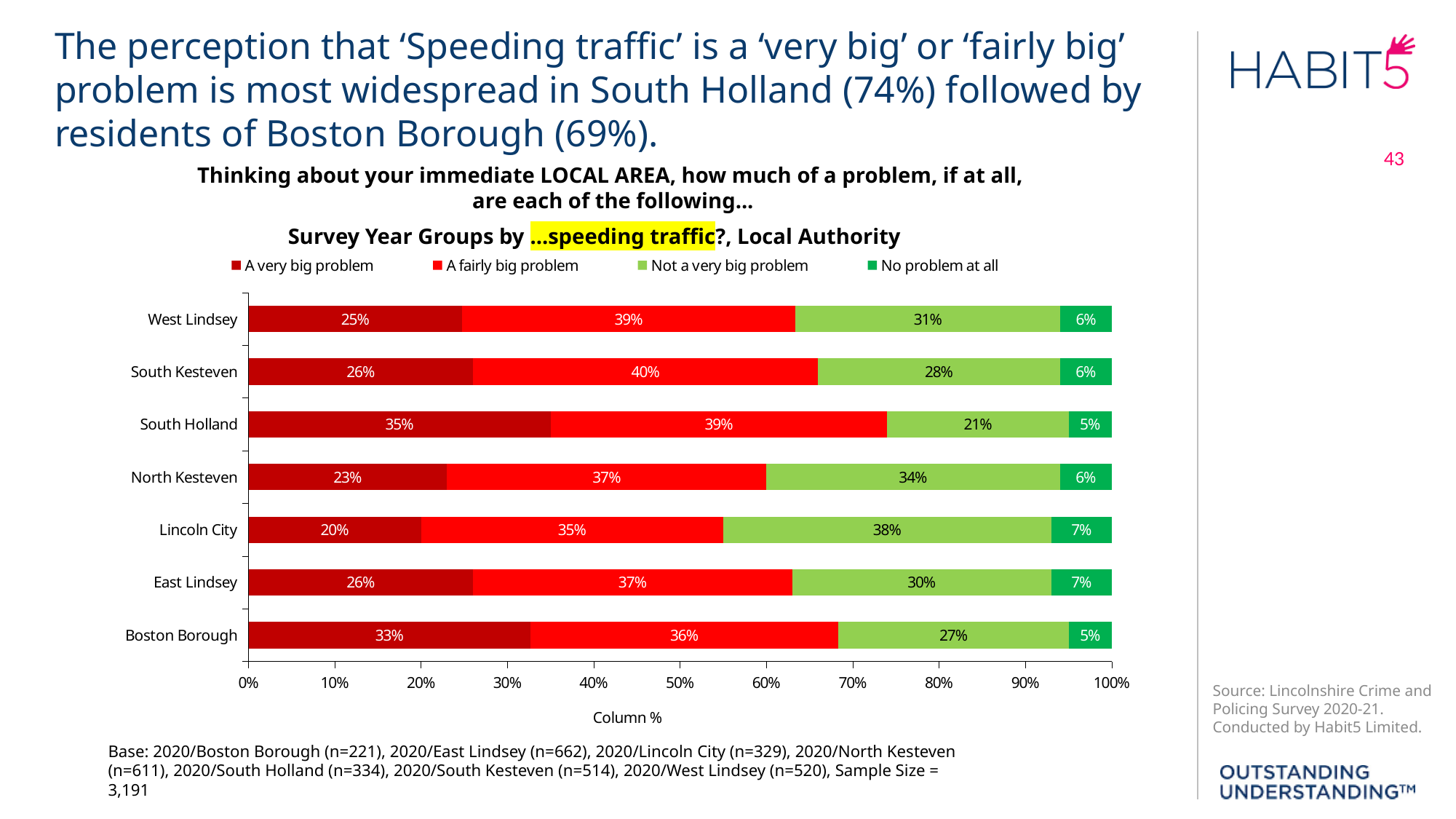
What is the difference between the 'A fairly big problem' values for South Kesteven and Lincoln City? 5 percentage points What percentage of Lincoln City respondents said speeding traffic is 'Not a very big problem'? 38% How many series does the legend list? 4 How many local authorities are shown on the chart? 7 What percentage of South Holland respondents said speeding traffic is 'A very big problem'? 35% What type of chart is shown on the slide? Stacked bar chart Which local authority has the highest share saying speeding traffic is 'A very big problem'? South Holland What is the combined 'A very big problem' and 'A fairly big problem' share for Boston Borough? 69% What is the label on the horizontal axis of the chart? Column % Which is larger: the 'Not a very big problem' value for North Kesteven or for Boston Borough? North Kesteven What percentage of East Lindsey respondents said speeding traffic is 'No problem at all'? 7% Which local authority has the lowest share saying speeding traffic is 'A very big problem'? Lincoln City